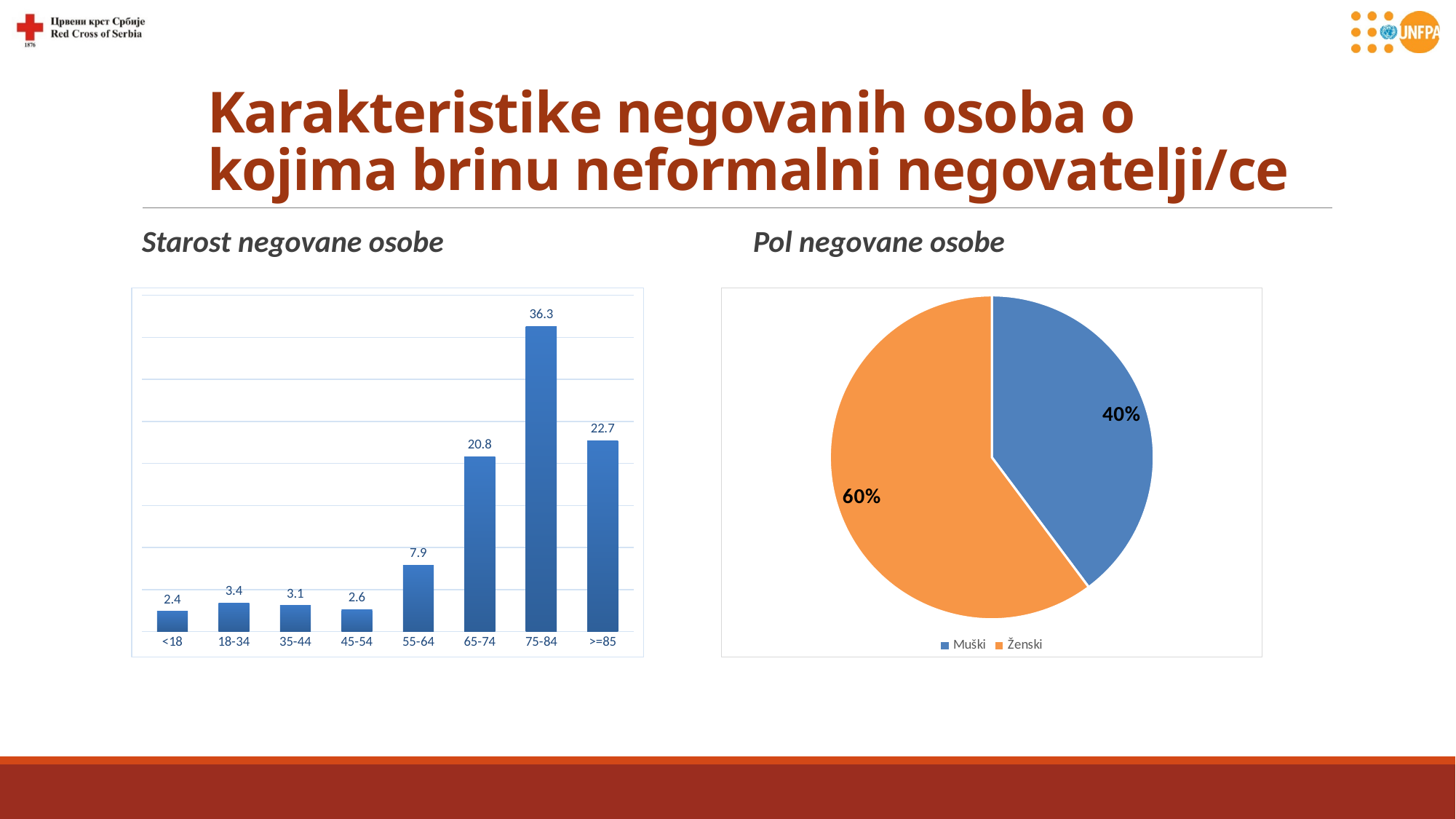
In the 'Starost negovane osobe' chart, which category has the highest value? 75-84 What kind of chart is the 'Pol negovane osobe' chart? Pie chart How many categories are shown in the 'Starost negovane osobe' chart? 8 In the 'Starost negovane osobe' chart, what is the difference between the values for 75-84 and >=85? 13.6 In the 'Starost negovane osobe' chart, which category has the lowest value? <18 In the 'Pol negovane osobe' chart, what is the value for Muški? 40% In the 'Starost negovane osobe' chart, what is the value for the 75-84 category? 36.3 In the 'Pol negovane osobe' chart, what share of the pie is Ženski? 60% In the 'Starost negovane osobe' chart, what is the value for the 55-64 category? 7.9 How many series does the legend of the 'Pol negovane osobe' chart list? 2 In the 'Starost negovane osobe' chart, which is larger, the value for 65-74 or the value for >=85? >=85 What kind of chart is the 'Starost negovane osobe' chart? Bar chart